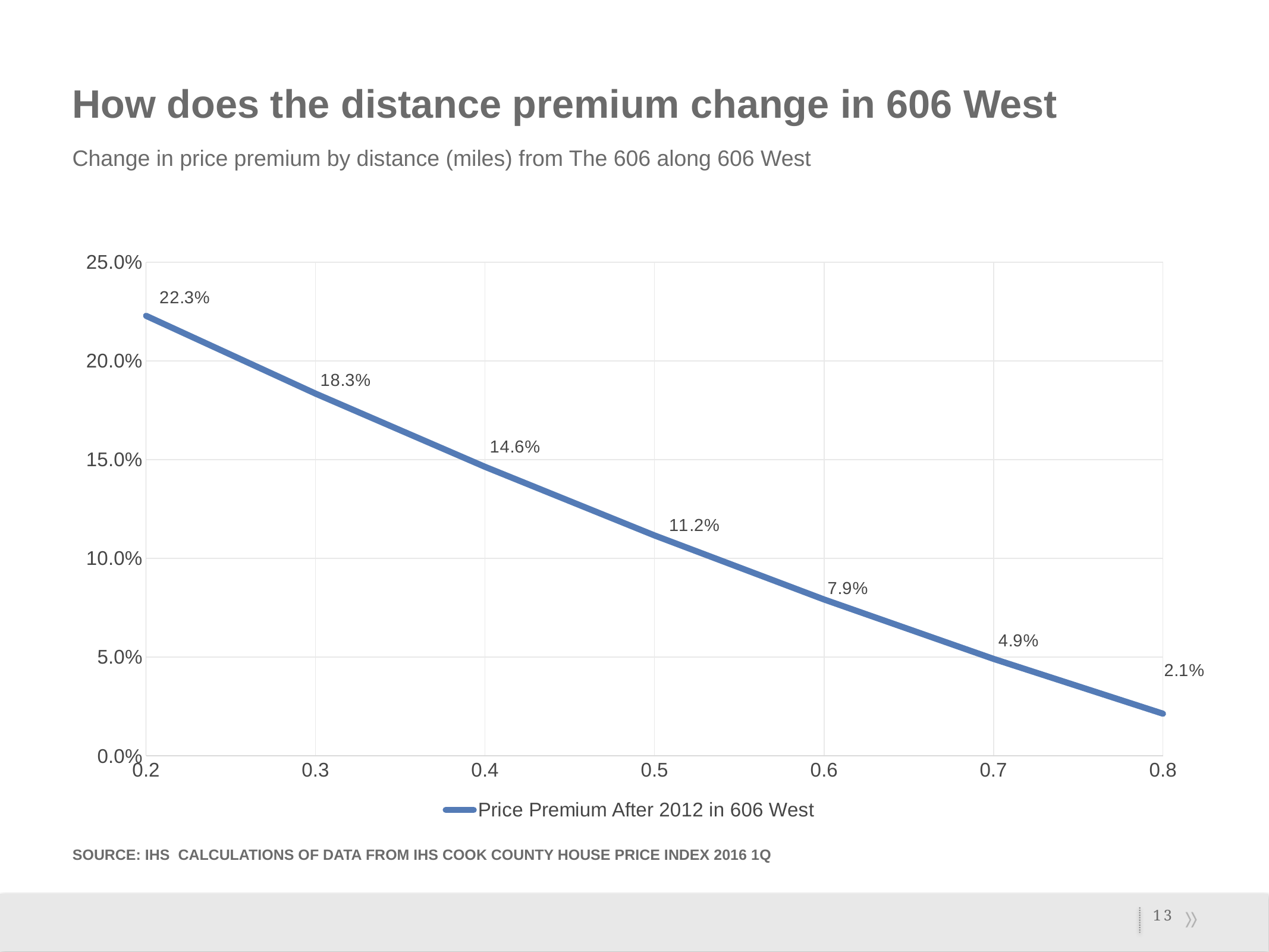
What is the price premium at a distance of 0.5 miles? 11.2% What kind of chart is shown on the slide? line chart What is the difference between the price premium at 0.6 miles and at 0.7 miles? 3.0% Does the price premium rise or fall as distance increases along the x axis? fall Is the price premium at 0.7 miles greater or less than 5.0%? less Which is larger, the price premium at 0.4 miles or at 0.6 miles? 0.4 miles What is the price premium at a distance of 0.2 miles? 22.3% What is the price premium at a distance of 0.8 miles? 2.1% What is the difference between the price premium at 0.2 miles and at 0.3 miles? 4.0% How many data points are plotted on the line? 7 At which distance is the price premium lowest? 0.8 At which distance is the price premium highest? 0.2